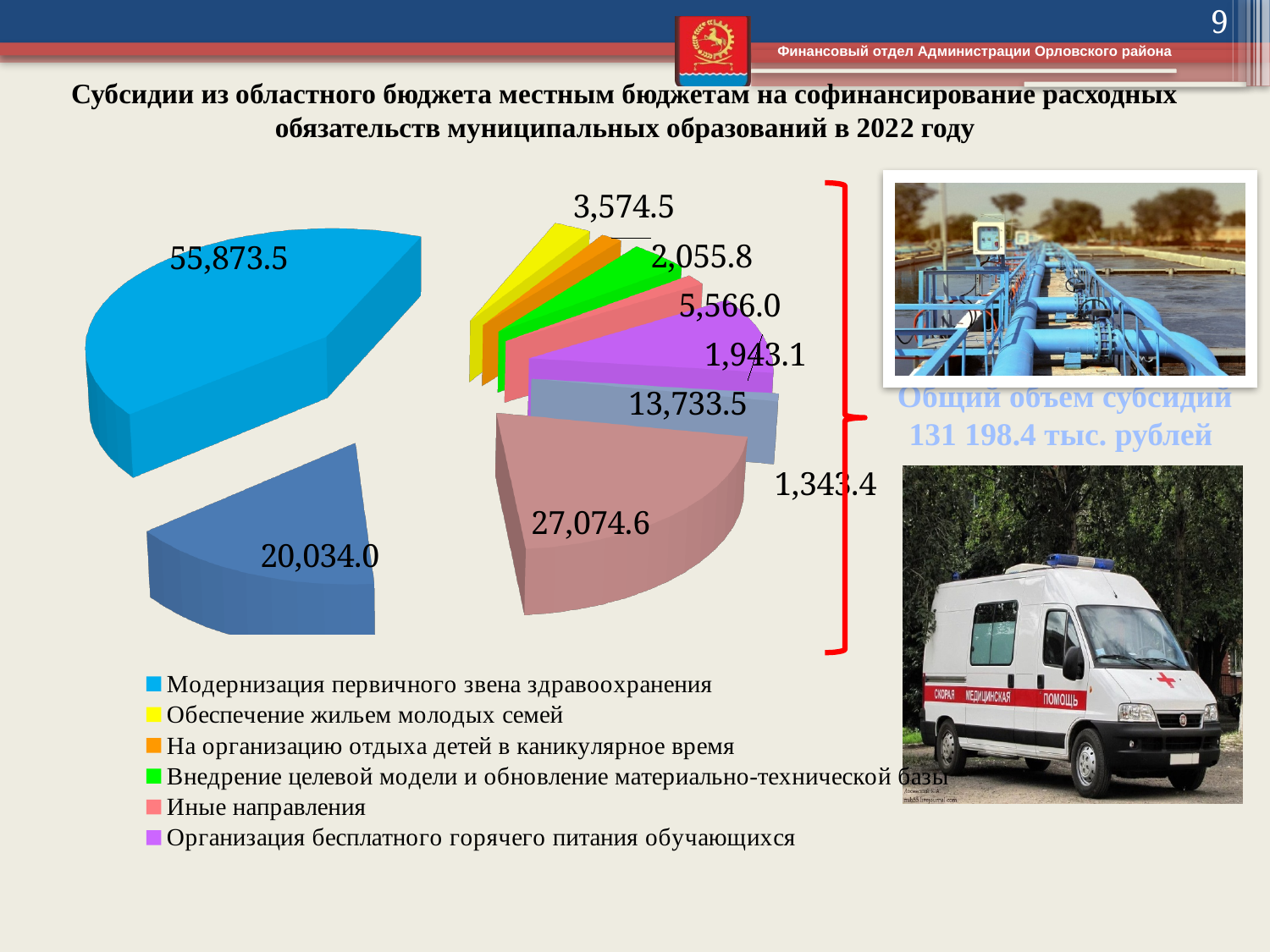
What value is shown for the light blue slice labelled 'Модернизация первичного звена здравоохранения'? 55,873.5 Which is larger: the slice labelled 27,074.6 or the slice labelled 20,034.0? 27,074.6 Which year does the chart title refer to? 2022 What kind of chart is shown on the slide? pie chart Which colour in the legend represents 'Организация бесплатного горячего питания обучающихся'? purple How many slices with data labels does the pie chart have? 9 How many entries does the legend list? 6 What is the difference between the slice labelled 55,873.5 and the slice labelled 27,074.6? 28,798.9 What total volume of subsidies is stated next to the pie chart? 131 198.4 тыс. рублей What is the value of the largest slice in the pie chart? 55,873.5 What is the difference between the slice labelled 27,074.6 and the slice labelled 20,034.0? 7,040.6 What is the value of the smallest slice in the pie chart? 1,343.4